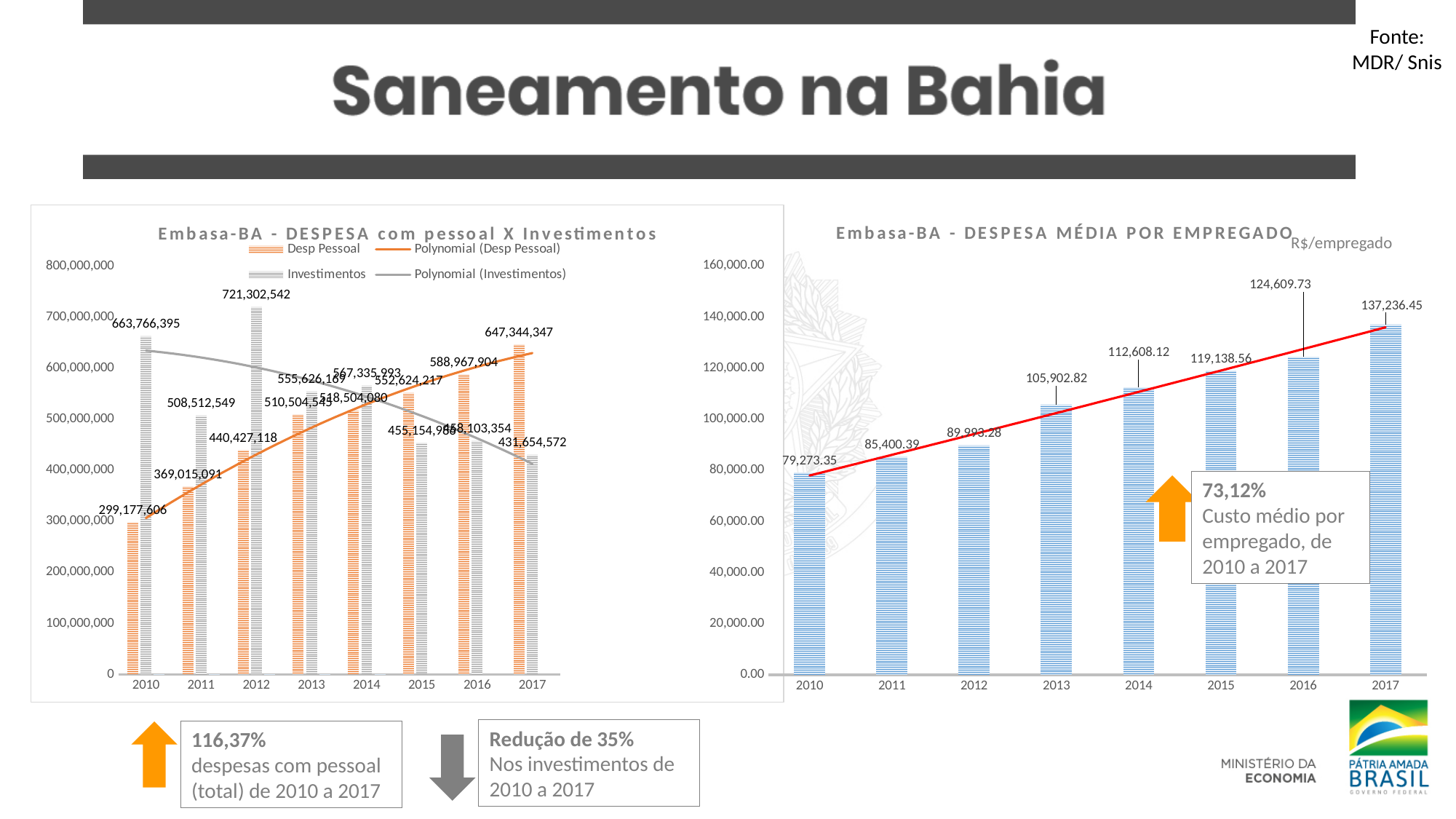
In the chart 'Embasa-BA - DESPESA com pessoal X Investimentos', which is larger in 2017: Desp Pessoal or Investimentos? Desp Pessoal In the chart 'Embasa-BA - DESPESA com pessoal X Investimentos', which year has the highest Investimentos value? 2012 In the chart 'Embasa-BA - DESPESA MÉDIA POR EMPREGADO', do the values rise or fall from 2010 to 2017? rise In the chart 'Embasa-BA - DESPESA MÉDIA POR EMPREGADO', how many years are shown on the x axis? 8 In the chart 'Embasa-BA - DESPESA MÉDIA POR EMPREGADO', what is the value for 2017? 137,236.45 In the chart 'Embasa-BA - DESPESA MÉDIA POR EMPREGADO', what is the difference between the 2017 and 2010 values? 57,963.10 In the chart 'Embasa-BA - DESPESA MÉDIA POR EMPREGADO', what is the value for 2010? 79,273.35 In the chart 'Embasa-BA - DESPESA com pessoal X Investimentos', what is the Investimentos value for 2012? 721,302,542 In the chart 'Embasa-BA - DESPESA MÉDIA POR EMPREGADO', which year has the highest value? 2017 In the chart 'Embasa-BA - DESPESA MÉDIA POR EMPREGADO', which year has the lowest value? 2010 In the chart 'Embasa-BA - DESPESA com pessoal X Investimentos', how many entries does the legend list? 4 In the chart 'Embasa-BA - DESPESA com pessoal X Investimentos', what is the Desp Pessoal value for 2010? 299,177,606